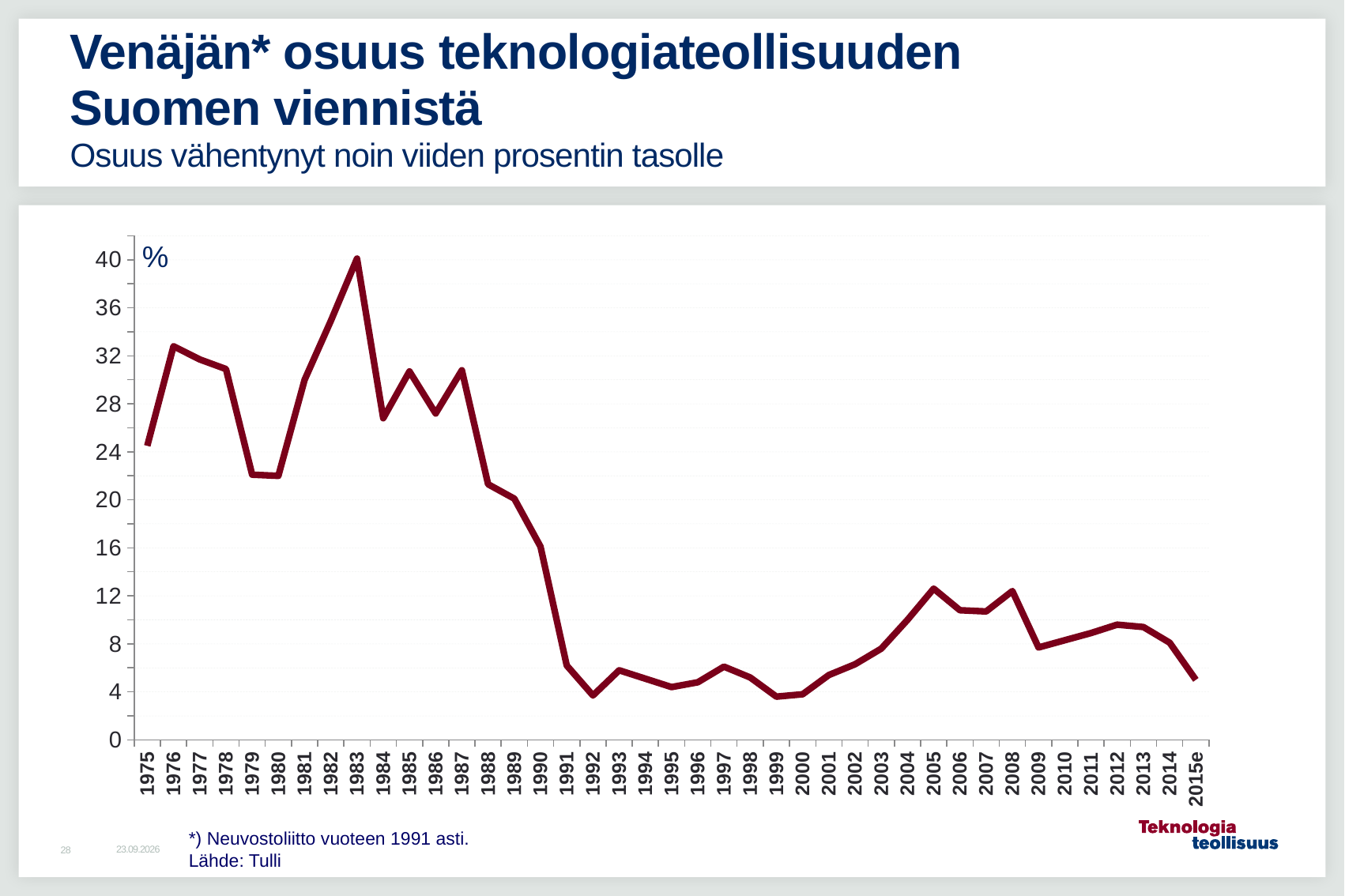
Which year has the larger value, 1983 or 1985? 1983 Is the value for 1976 greater or less than 28? greater What kind of chart is shown on the slide? line chart Does the line rise or fall between 1983 and 1992? fall What unit is shown at the top of the vertical axis? % In which year does the line reach its highest value? 1983 Is the value for 1979 greater or less than 24? less Is the value for 1983 greater or less than 36? greater Does the line rise or fall between 1999 and 2005? rise Which year has the larger value, 2000 or 2005? 2005